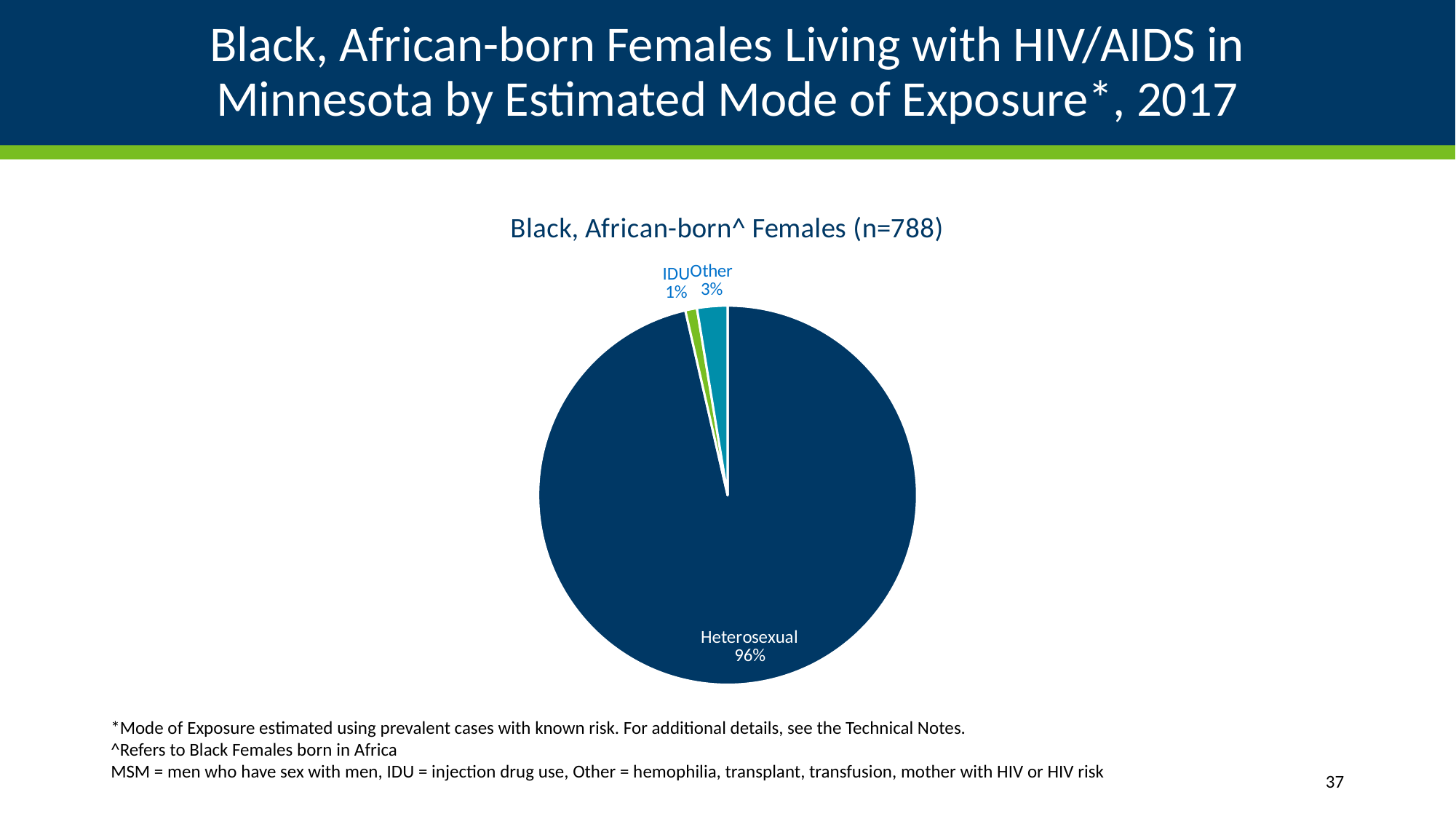
Which mode of exposure has the smallest slice of the pie? IDU What kind of chart is shown on the slide? pie chart What share of the pie does IDU account for? 1% Which mode of exposure has the largest slice of the pie? Heterosexual What share of the pie does Other account for? 3% How many slices does the pie chart have? 3 What is the title of the pie chart? Black, African-born^ Females (n=788) Which is larger, the share for Other or the share for IDU? Other What is the sample size (n) given in the chart title? 788 What is the difference in percentage points between the Other share and the IDU share? 2 What share of the pie does Heterosexual account for? 96% What is the difference in percentage points between the Heterosexual share and the Other share? 93